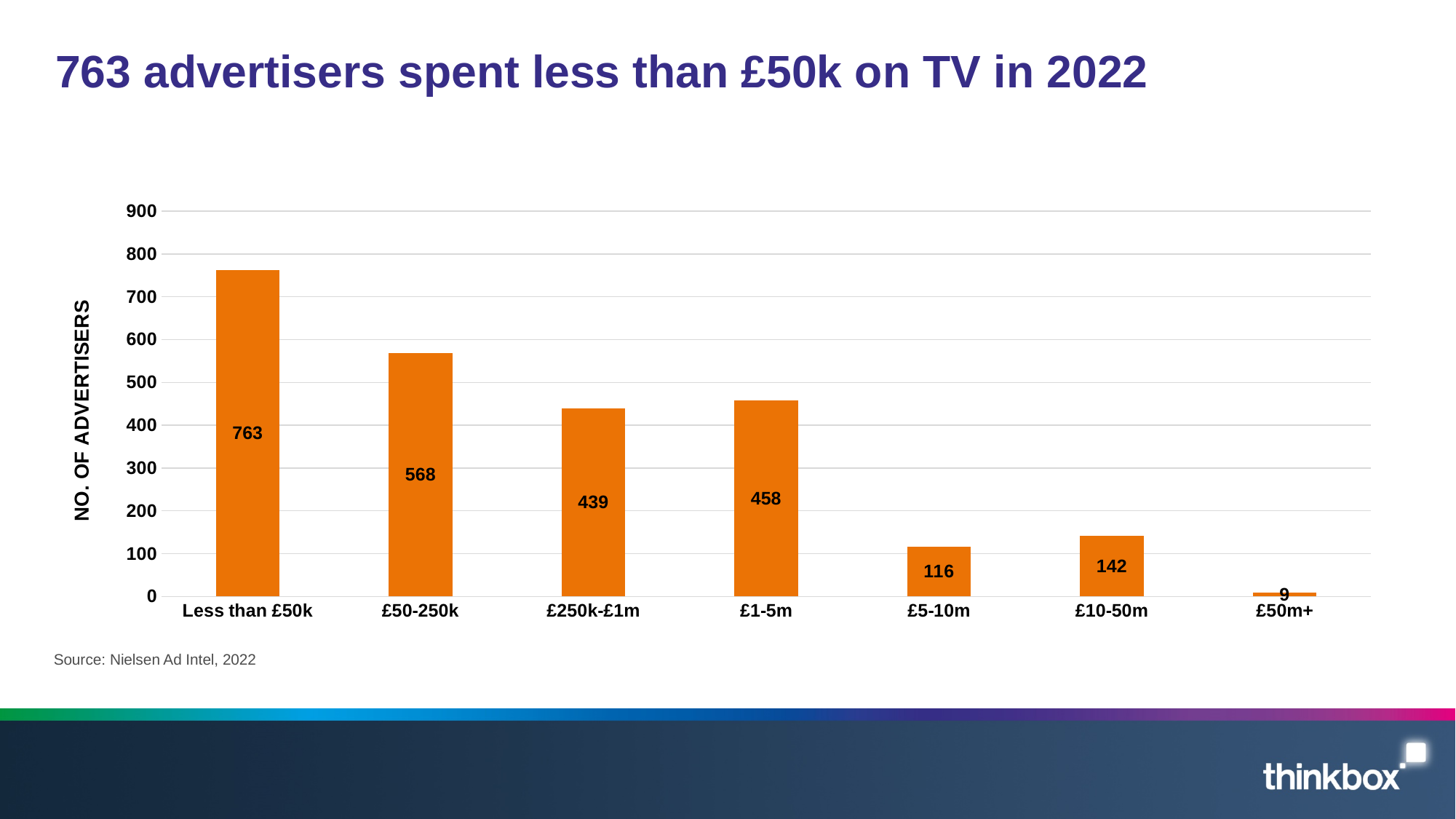
Which has more advertisers: £250k-£1m or £1-5m? £1-5m Which spend band has the lowest number of advertisers? £50m+ How many advertisers spent £50-250k on TV in 2022? 568 How many spend bands are shown on the x axis? 7 Which spend band has the highest number of advertisers? Less than £50k What is the difference between the number of advertisers in the Less than £50k band and the £50-250k band? 195 How many advertisers are shown for the £50m+ band? 9 What is the number of advertisers in the £1-5m spend band? 458 Is the value for £5-10m greater or less than 200? less What type of chart is shown on the slide? Bar chart What is the label on the vertical axis? NO. OF ADVERTISERS How many more advertisers are in the £10-50m band than in the £5-10m band? 26